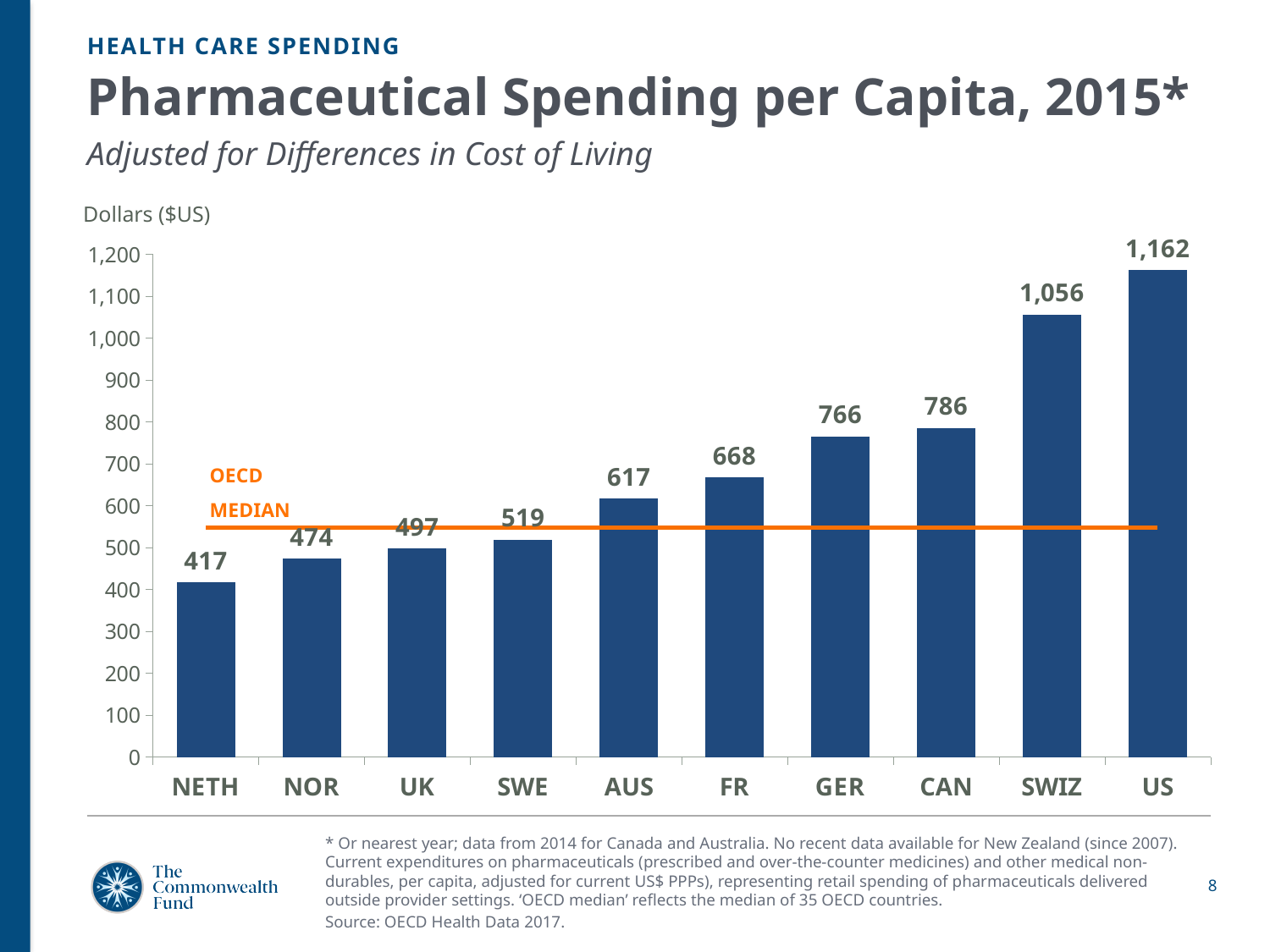
What is the difference in pharmaceutical spending per capita between the US and Switzerland (SWIZ)? 106 Which country has the lowest pharmaceutical spending per capita? NETH Which country has the highest pharmaceutical spending per capita? US What is the difference in pharmaceutical spending per capita between Canada (CAN) and the Netherlands (NETH)? 369 Is the OECD median line greater or less than 600? less What is the pharmaceutical spending per capita for Germany (GER)? 766 How many countries are shown in the chart? 10 What is the pharmaceutical spending per capita for the US? 1,162 What type of chart is shown on the slide? bar chart What is the pharmaceutical spending per capita for Sweden (SWE)? 519 Do the values rise or fall from left to right across the countries? rise Which has higher pharmaceutical spending per capita, France (FR) or Australia (AUS)? FR